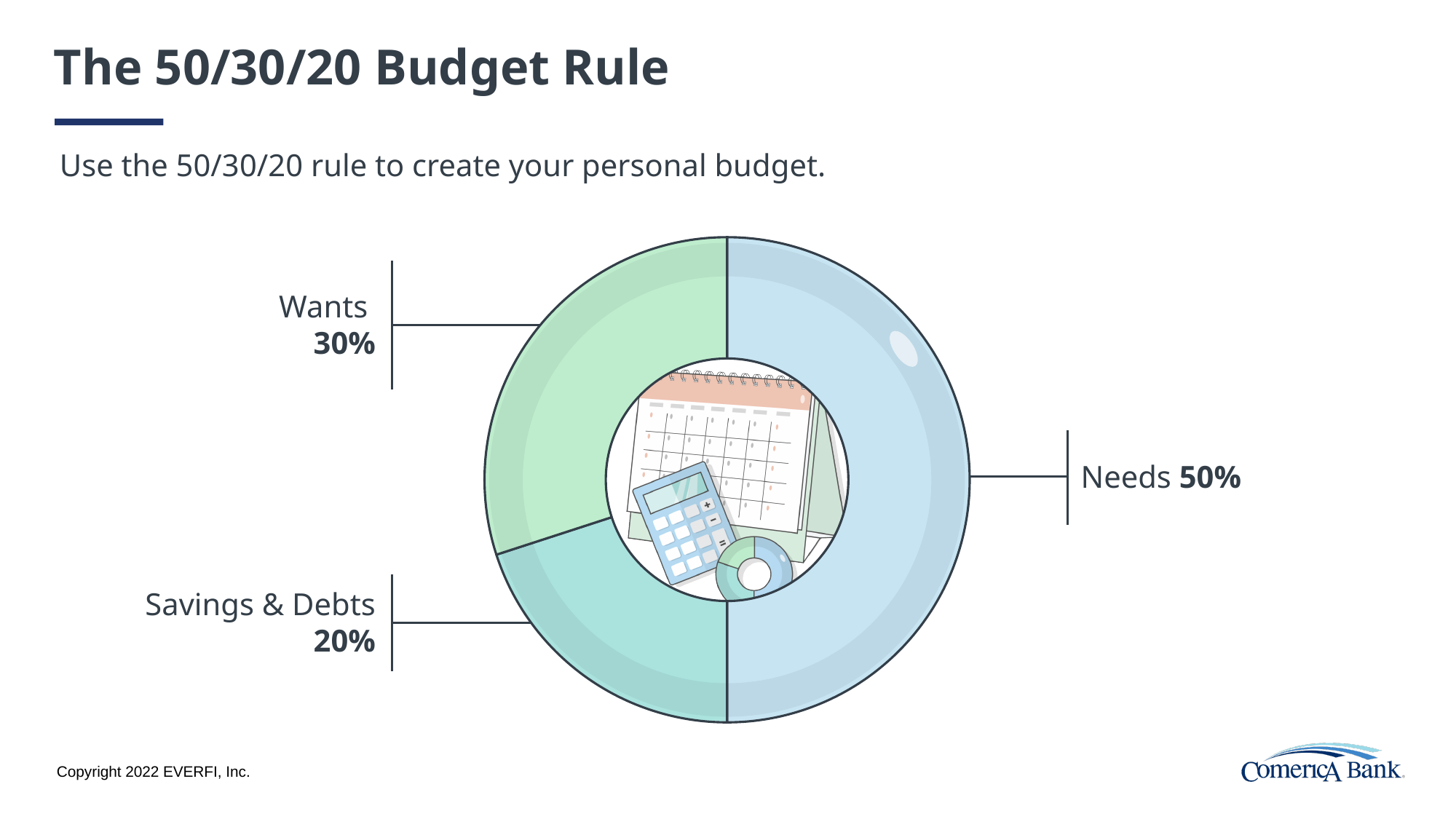
What percentage is allocated to Needs in the chart? 50% What percentage is allocated to Savings & Debts in the chart? 20% Which is larger, the share for Wants or the share for Savings & Debts? Wants What percentage is allocated to Wants in the chart? 30% What is the difference between the Wants share and the Savings & Debts share? 10% What kind of chart is shown on the slide? Pie chart (donut) Which category has the smallest share of the chart? Savings & Debts Which category has the largest share of the chart? Needs How many categories are shown in the chart? 3 What is the title of the slide containing the chart? The 50/30/20 Budget Rule What is the combined share of Wants and Savings & Debts? 50% What is the difference between the Needs share and the Wants share? 20%